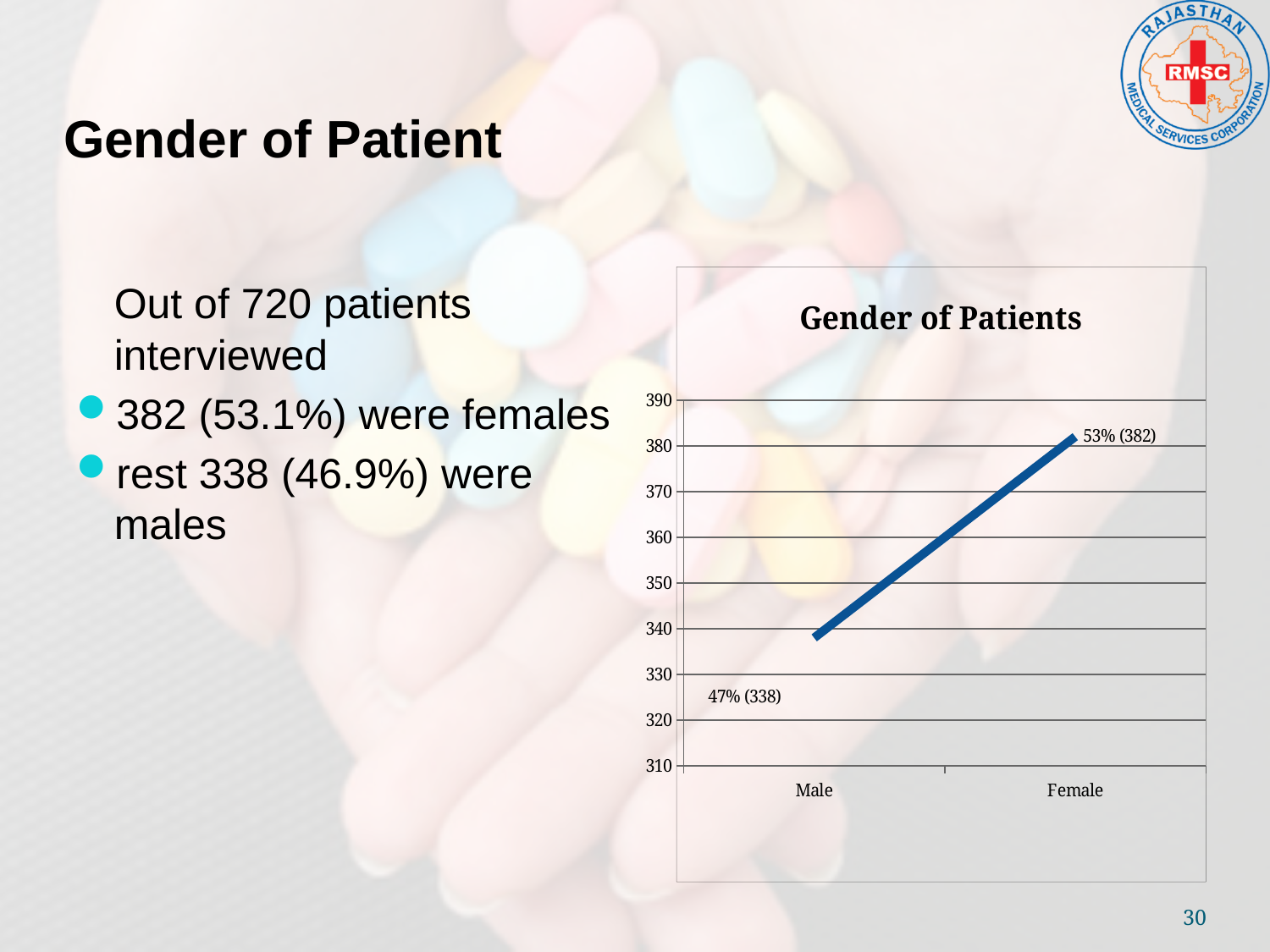
Which category has the lowest value? Male What is the data label shown for Female? 53% (382) Is the value for Male greater or less than 340? less How many categories are shown on the x axis? 2 Which category has the higher value, Male or Female? Female What kind of chart is shown on the slide? line chart Does the line rise or fall from Male to Female? rises What is the difference between the number of Female and Male patients? 44 How many patients are Male according to the chart? 338 What is the data label shown for Male? 47% (338) How many patients are Female according to the chart? 382 What is the title of the chart? Gender of Patients